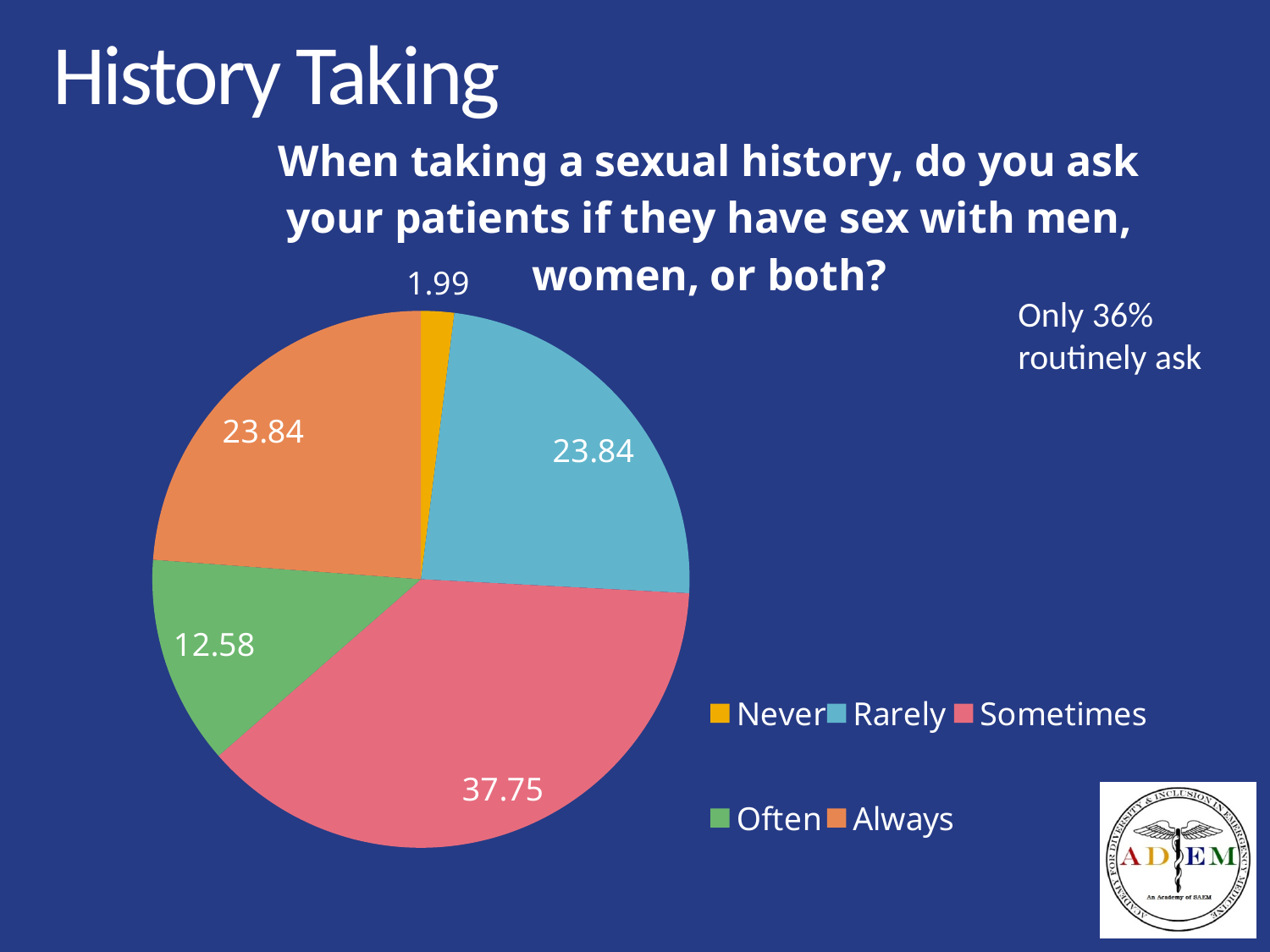
What is the value for Sometimes in the pie chart? 37.75 Which category has the largest slice of the pie chart? Sometimes How many categories does the pie chart have? 5 Which category has the smallest slice of the pie chart? Never Which is larger, the value for Sometimes or the value for Always? Sometimes What is the value for Often in the pie chart? 12.58 What is the difference between the values for Always and Never? 21.85 What is the value for Never in the pie chart? 1.99 What type of chart is shown on the slide? pie chart What is the value for Rarely in the pie chart? 23.84 What is the difference between the values for Sometimes and Often? 25.17 Which colour represents Often in the pie chart? green